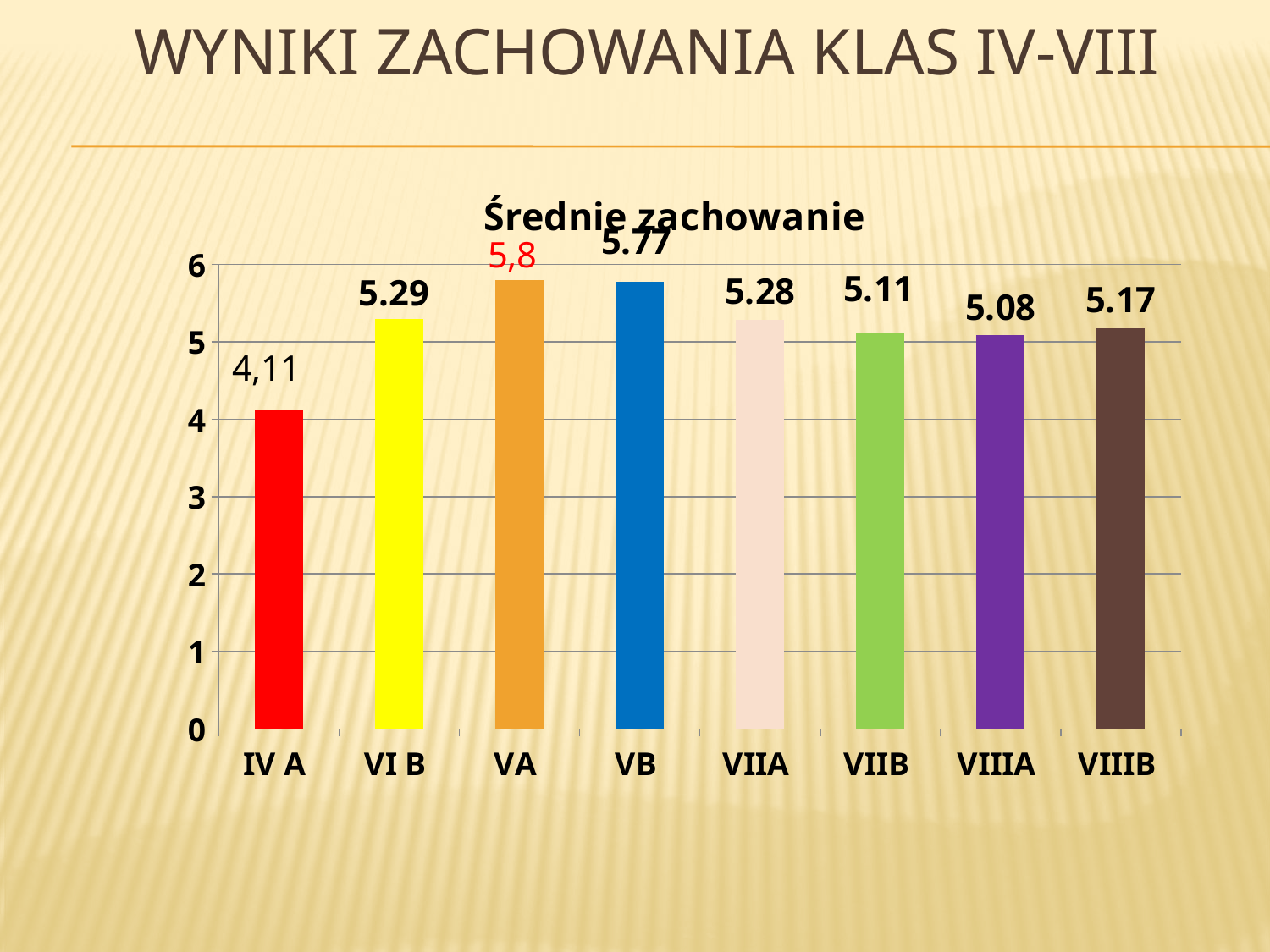
Which class has the lowest value in the Średnie zachowanie chart? IV A Which has a larger value in the Średnie zachowanie chart, VI B or VIIB? VI B What is the value shown for VA in the Średnie zachowanie chart? 5,8 What kind of chart is shown on the slide? bar chart What is the difference between the values for VB and VIIIA in the Średnie zachowanie chart? 0.69 What is the difference between the values for VB and VIIA in the Średnie zachowanie chart? 0.49 What is the value shown for VIIIA in the Średnie zachowanie chart? 5.08 How many classes are shown in the Średnie zachowanie chart? 8 Which class has the highest value in the Średnie zachowanie chart? VA Is the value for IV A in the Średnie zachowanie chart greater or less than 5? less What is the value shown for VB in the Średnie zachowanie chart? 5.77 What is the value shown for IV A in the Średnie zachowanie chart? 4,11